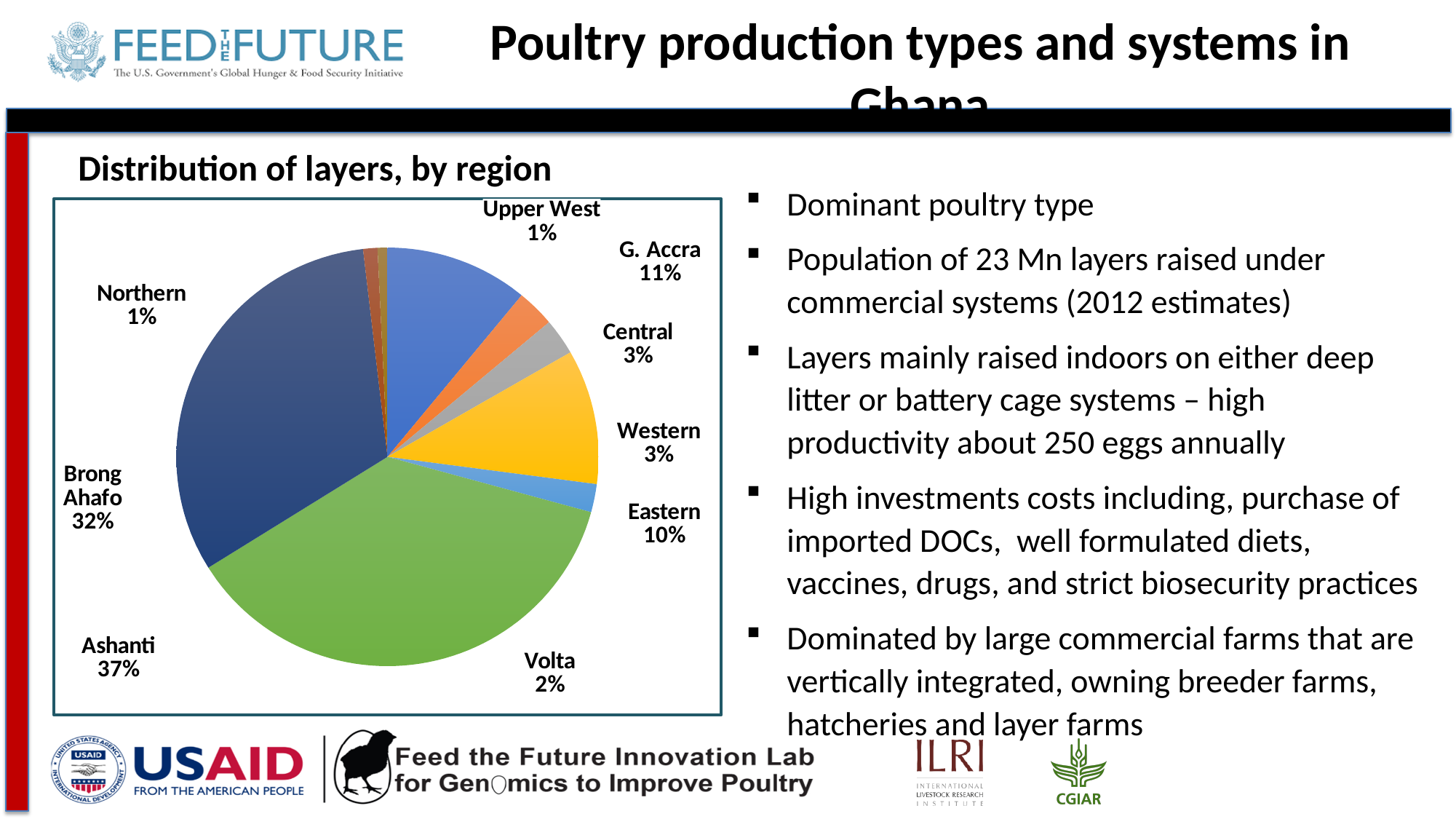
What share does the Volta region have? 2% What share of layers is in the Ashanti region? 37% What kind of chart is used to show the distribution of layers by region? Pie chart Which region has the largest share of layers? Ashanti How many percentage points larger is Ashanti's share than Brong Ahafo's? 5 What is the title of the chart? Distribution of layers, by region What is the combined share of Ashanti and Brong Ahafo? 69% What is the share for G. Accra? 11% How many regions are shown in the pie chart? 9 What percentage of layers is in the Eastern region? 10% Which has a larger share of layers, G. Accra or Eastern? G. Accra What percentage of layers is in Brong Ahafo? 32%